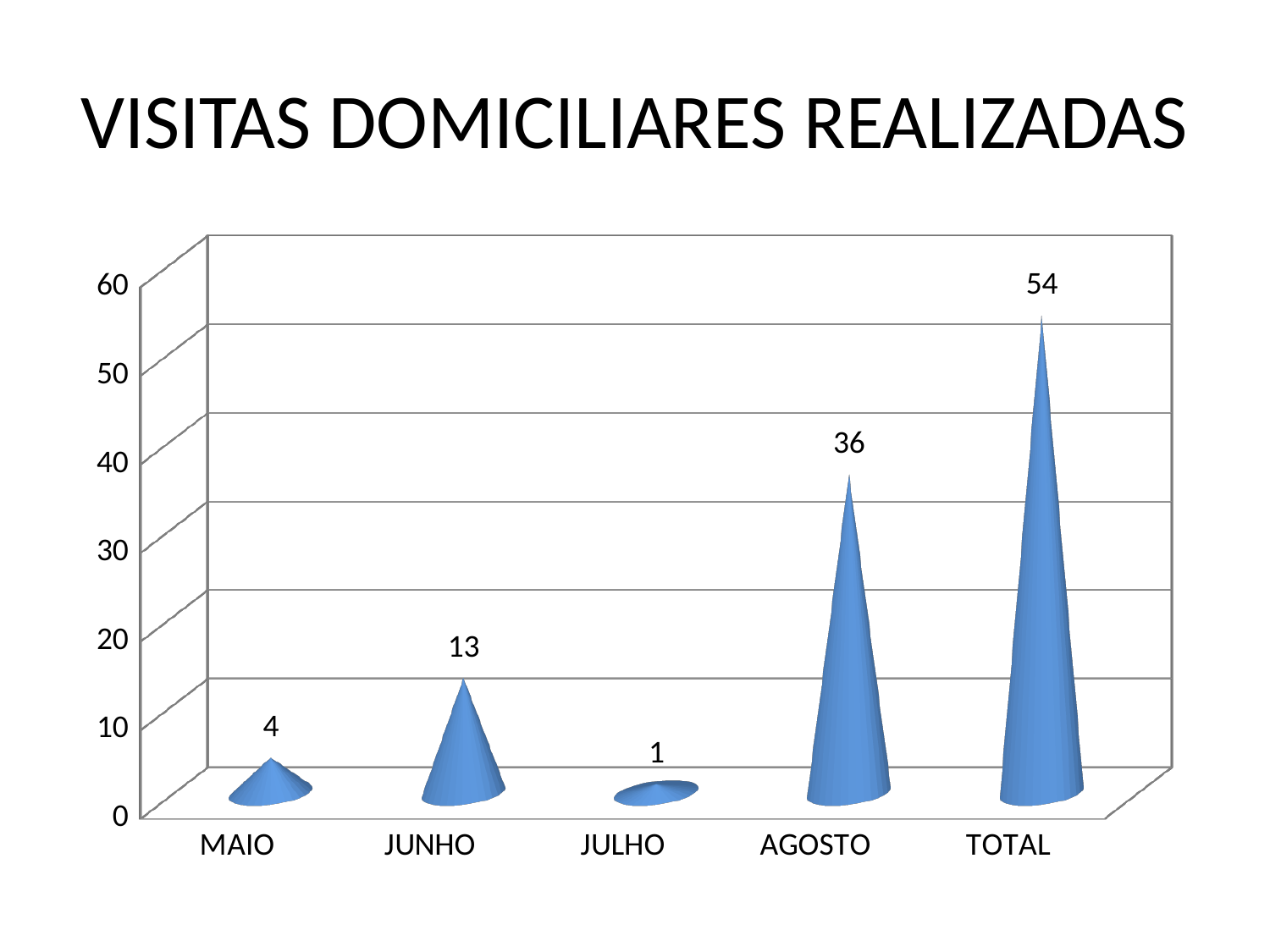
Which category has the lowest value? JULHO What is the difference between the values for AGOSTO and JUNHO? 23 Which category has the highest value? TOTAL What is the value for AGOSTO? 36 What is the value for MAIO? 4 How many categories are shown on the x axis? 5 Which is larger, the value for MAIO or the value for JUNHO? JUNHO What is the title of the chart? VISITAS DOMICILIARES REALIZADAS What is the value for TOTAL? 54 Is the value for AGOSTO greater or less than 30? greater What is the value for JUNHO? 13 What kind of chart is shown on the slide? bar chart